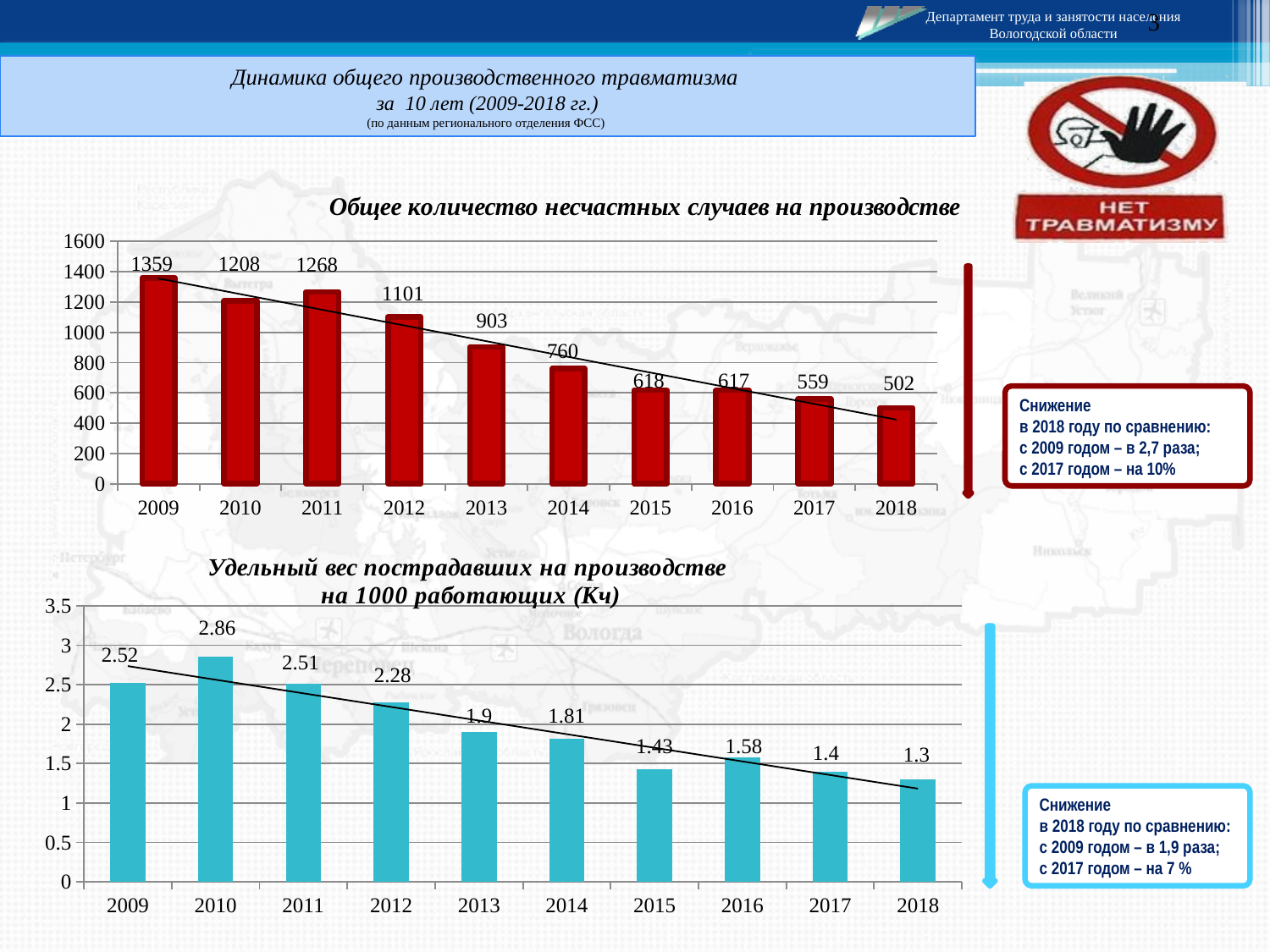
In the bottom chart 'Удельный вес пострадавших на производстве на 1000 работающих (Кч)', what is the difference between the values for 2010 and 2018? 1.56 What kind of chart is the top chart 'Общее количество несчастных случаев на производстве'? bar chart In the bottom chart 'Удельный вес пострадавших на производстве на 1000 работающих (Кч)', what is the value for 2014? 1.81 What colour are the bars in the bottom chart 'Удельный вес пострадавших на производстве на 1000 работающих (Кч)'? blue In the bottom chart 'Удельный вес пострадавших на производстве на 1000 работающих (Кч)', which year has the highest value? 2010 In the top chart 'Общее количество несчастных случаев на производстве', which is larger, the value for 2010 or the value for 2011? 2011 In the top chart 'Общее количество несчастных случаев на производстве', what is the value for 2013? 903 In the top chart 'Общее количество несчастных случаев на производстве', what is the difference between the values for 2009 and 2018? 857 In the top chart 'Общее количество несчастных случаев на производстве', which year has the highest value? 2009 How many years are shown on the x axis of the top chart 'Общее количество несчастных случаев на производстве'? 10 In the bottom chart 'Удельный вес пострадавших на производстве на 1000 работающих (Кч)', do the values generally rise or fall from 2009 to 2018? fall In the top chart 'Общее количество несчастных случаев на производстве', which year has the lowest value? 2018